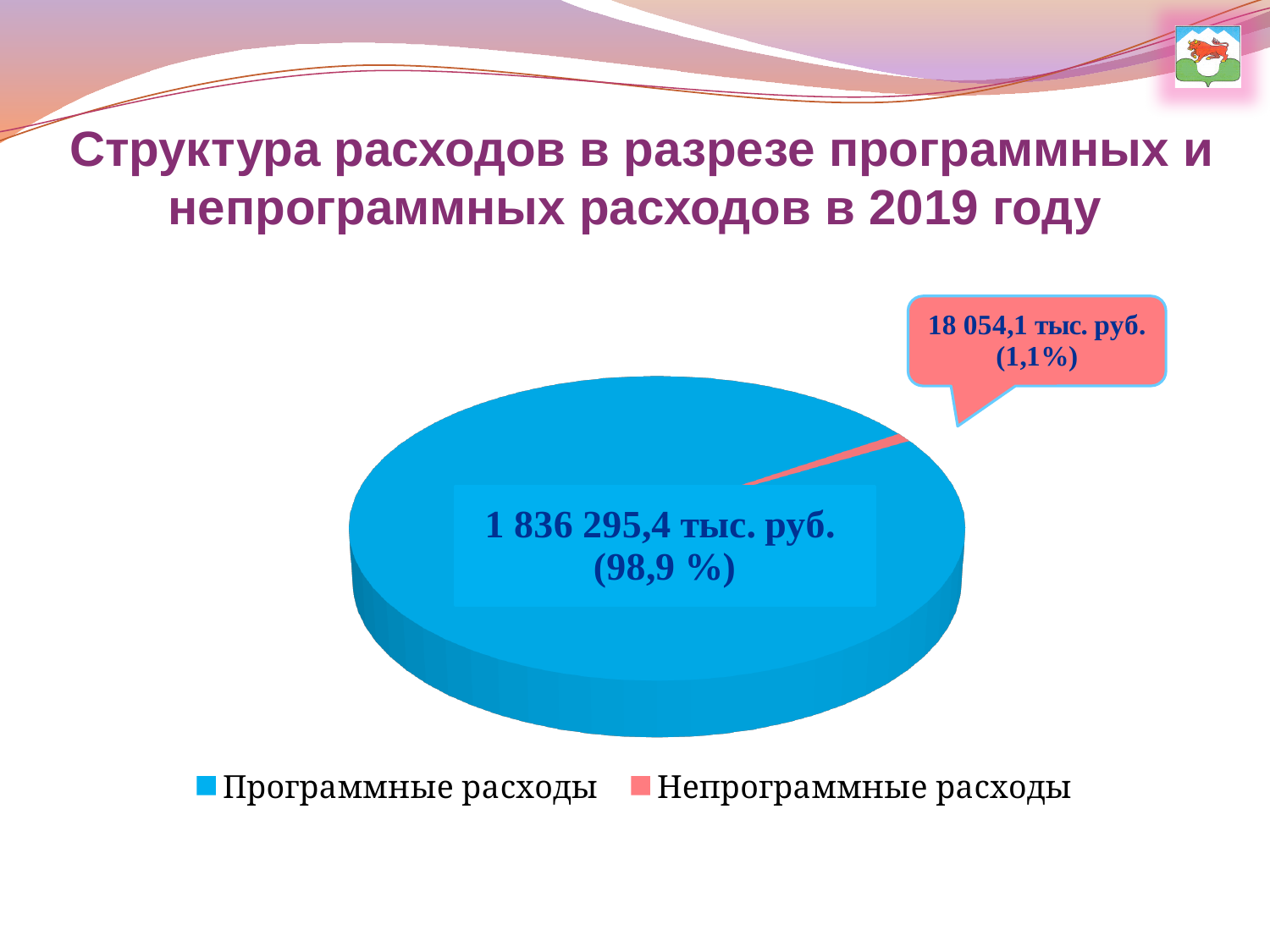
What is the value for Непрограммные расходы? 18 054,1 тыс. руб. What is the title of the slide? Структура расходов в разрезе программных и непрограммных расходов в 2019 году Which category has the largest slice? Программные расходы What colour is the slice for Непрограммные расходы? pink/red Which is larger, Программные расходы or Непрограммные расходы? Программные расходы How many entries does the legend list? 2 What is the value for Программные расходы? 1 836 295,4 тыс. руб. What share of the pie does Программные расходы take? 98,9 % What share of the pie does Непрограммные расходы take? 1,1% How many categories does the pie chart have? 2 What kind of chart is shown on the slide? pie chart Which category has the smallest slice? Непрограммные расходы